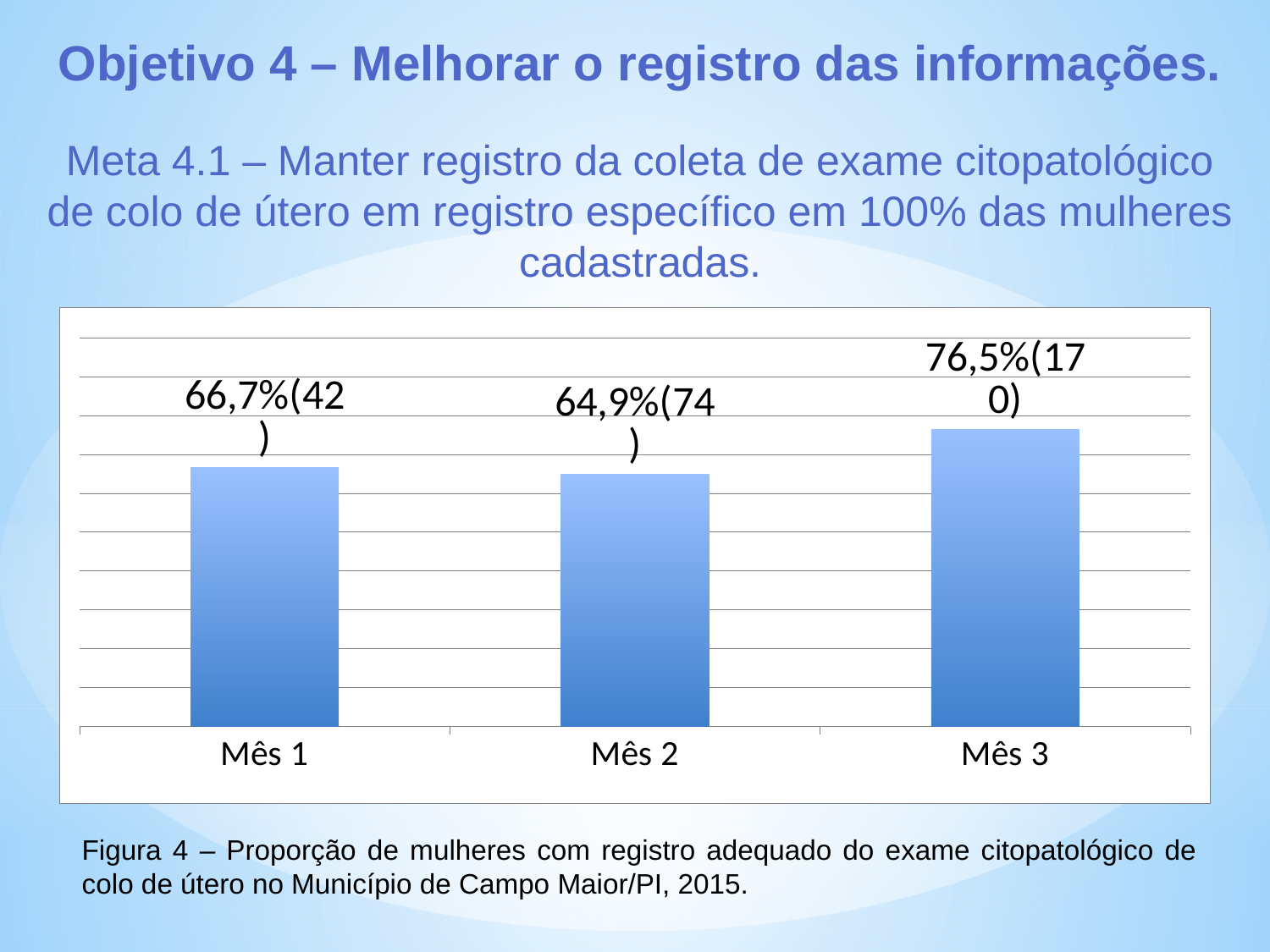
Does the value rise or fall from Mês 2 to Mês 3? Rise Which month has the highest value? Mês 3 Which month has the lowest value? Mês 2 What number appears in parentheses in the data label for Mês 1? 42 Which is larger, the value for Mês 1 or the value for Mês 3? Mês 3 What is the value shown for Mês 3? 76,5% How many months (categories) are shown on the chart? 3 What kind of chart is shown on the slide? Bar chart What number appears in parentheses in the data label for Mês 3? 170 What is the value shown for Mês 2? 64,9% What is the difference in percentage points between Mês 3 and Mês 1? 9,8 What is the value shown for Mês 1? 66,7%